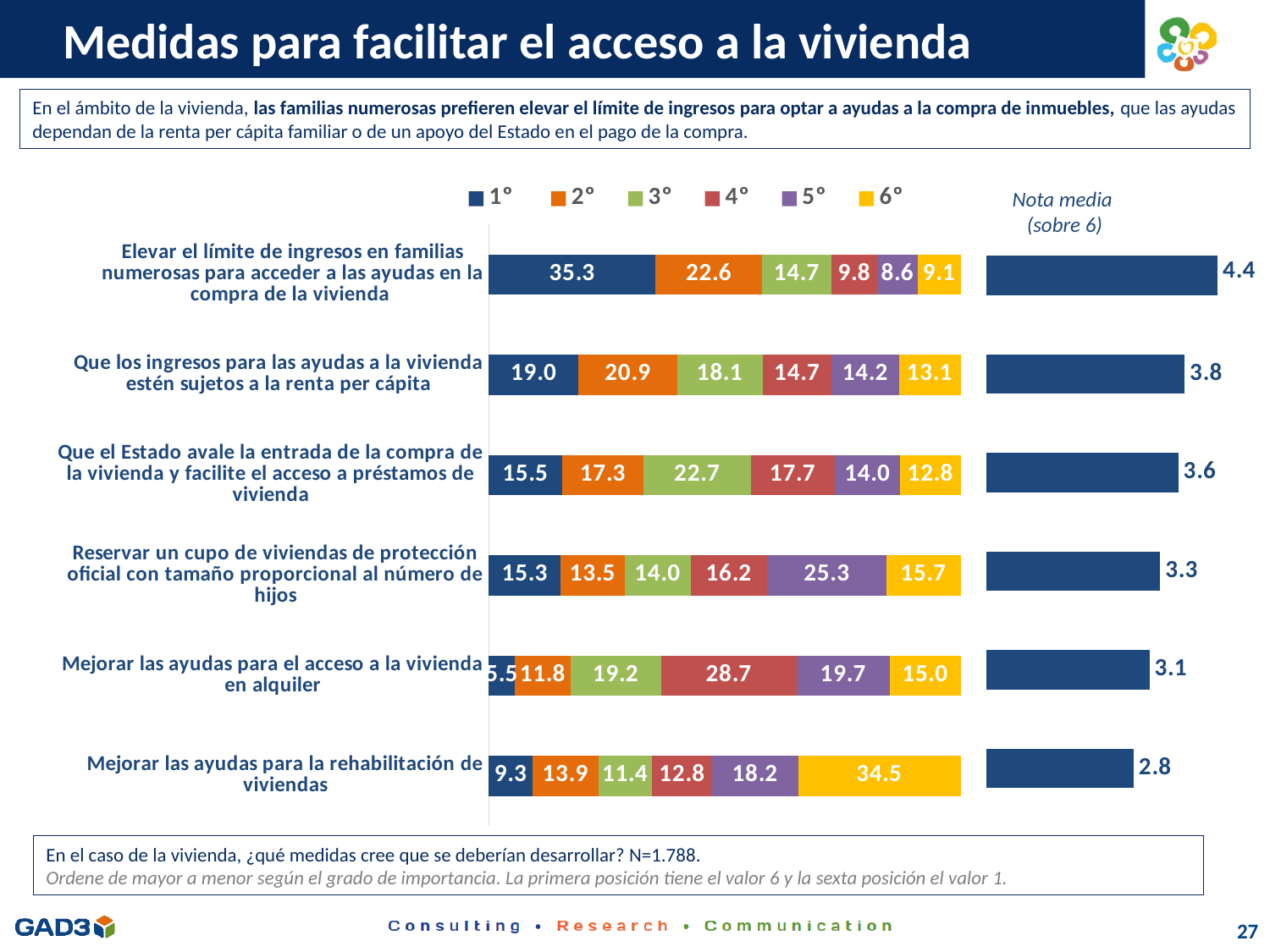
How many series does the legend of the stacked bar chart list? 6 In the stacked bar chart, what is the difference between the 1° and 2° values for 'Elevar el límite de ingresos en familias numerosas para acceder a las ayudas en la compra de la vivienda'? 12.7 In the stacked bar chart, what is the value of the 1° series for 'Elevar el límite de ingresos en familias numerosas para acceder a las ayudas en la compra de la vivienda'? 35.3 In the 'Nota media (sobre 6)' chart, which measure has the highest value? Elevar el límite de ingresos en familias numerosas para acceder a las ayudas en la compra de la vivienda What kind of chart is the chart on the left of the slide? Stacked bar chart In the stacked bar chart, what is the value of the 5° series for 'Reservar un cupo de viviendas de protección oficial con tamaño proporcional al número de hijos'? 25.3 In the stacked bar chart, which has a larger 6° value: 'Mejorar las ayudas para la rehabilitación de viviendas' or 'Mejorar las ayudas para el acceso a la vivienda en alquiler'? Mejorar las ayudas para la rehabilitación de viviendas In the 'Nota media (sobre 6)' chart, what is the difference between the value for 'Elevar el límite de ingresos en familias numerosas...' and the value for 'Que los ingresos para las ayudas a la vivienda estén sujetos a la renta per cápita'? 0.6 In the 'Nota media (sobre 6)' chart, what is the value for 'Que el Estado avale la entrada de la compra de la vivienda y facilite el acceso a préstamos de vivienda'? 3.6 What is the title of the chart on the right side of the slide? Nota media (sobre 6) In the 'Nota media (sobre 6)' chart, which measure has the lowest value? Mejorar las ayudas para la rehabilitación de viviendas How many measures (categories) are shown in the stacked bar chart? 6